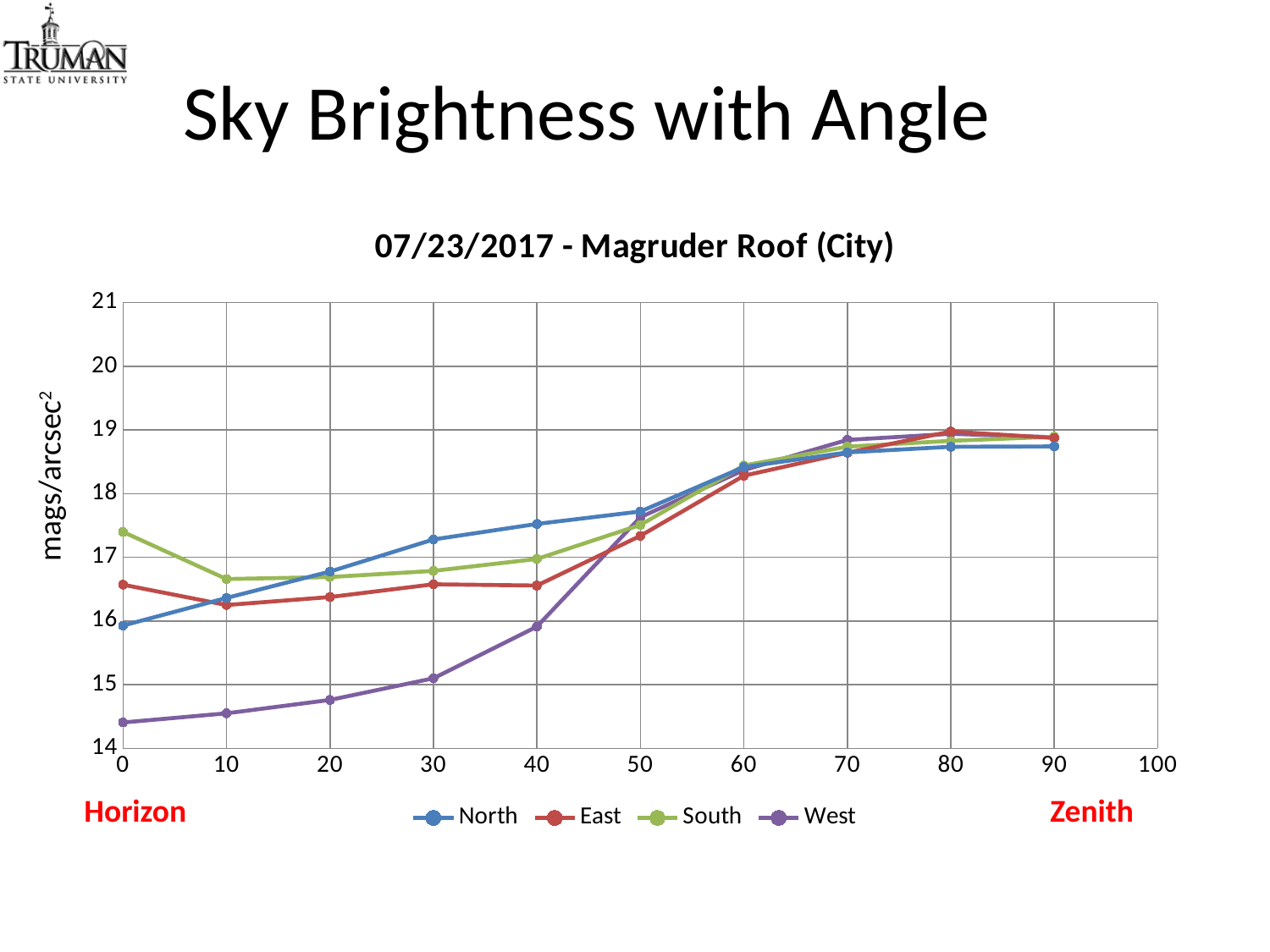
What is the title of the chart? 07/23/2017 - Magruder Roof (City) Is the value for East at angle 40 greater or less than 17? less At angle 0, which series has the larger value, North or West? North What kind of chart is shown on the slide? line chart Is the value for South at angle 0 greater or less than 17? greater Which series has the lowest value at angle 0? West Is the value for West at angle 0 greater or less than 15? less At angle 30, which series has the larger value, North or East? North How many series does the legend list? 4 Which series has the highest value at angle 0? South How many data points are plotted for the North series? 10 Does the West series rise or fall as the angle increases from 0 to 90? rise